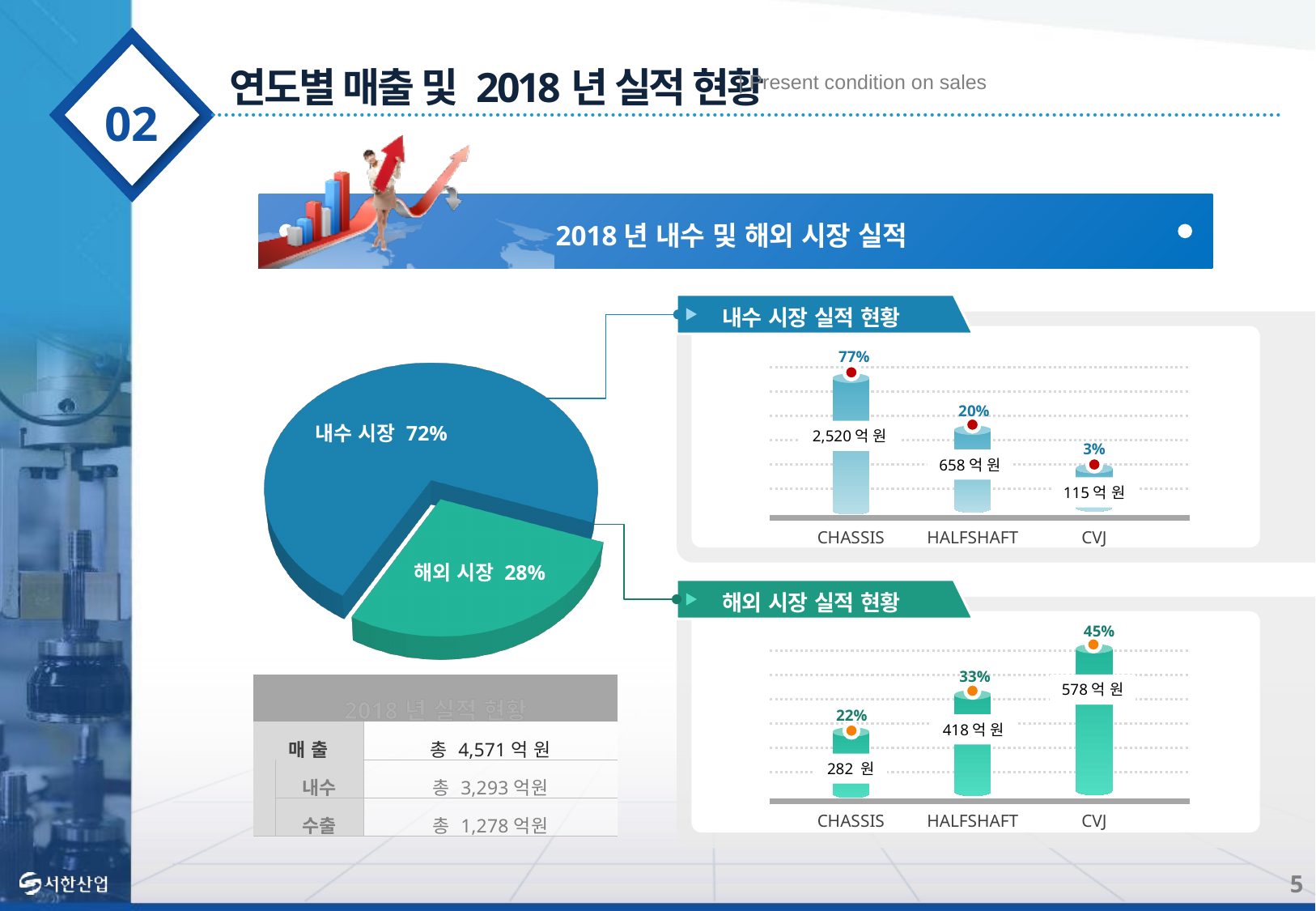
In the 내수 시장 실적 현황 chart, what percentage is shown for HALFSHAFT? 20% In the 내수 시장 실적 현황 chart, what is the value for CHASSIS? 2,520 억 원 In the pie chart, what share does 내수 시장 have? 72% In the 내수 시장 실적 현황 chart, which category has the lowest value? CVJ How many categories are shown in the 해외 시장 실적 현황 chart? 3 In the 해외 시장 실적 현황 chart, what is the value for CVJ? 578 억 원 In the pie chart, which slice is larger, 내수 시장 or 해외 시장? 내수 시장 In the pie chart, what share does 해외 시장 have? 28% In the 내수 시장 실적 현황 chart, what is the difference between the CHASSIS and HALFSHAFT values in 억 원? 1,862 억 원 In the 해외 시장 실적 현황 chart, which category has the highest value? CVJ In the 해외 시장 실적 현황 chart, what percentage is shown for HALFSHAFT? 33% What kind of chart is the 내수 시장 실적 현황 chart? bar chart